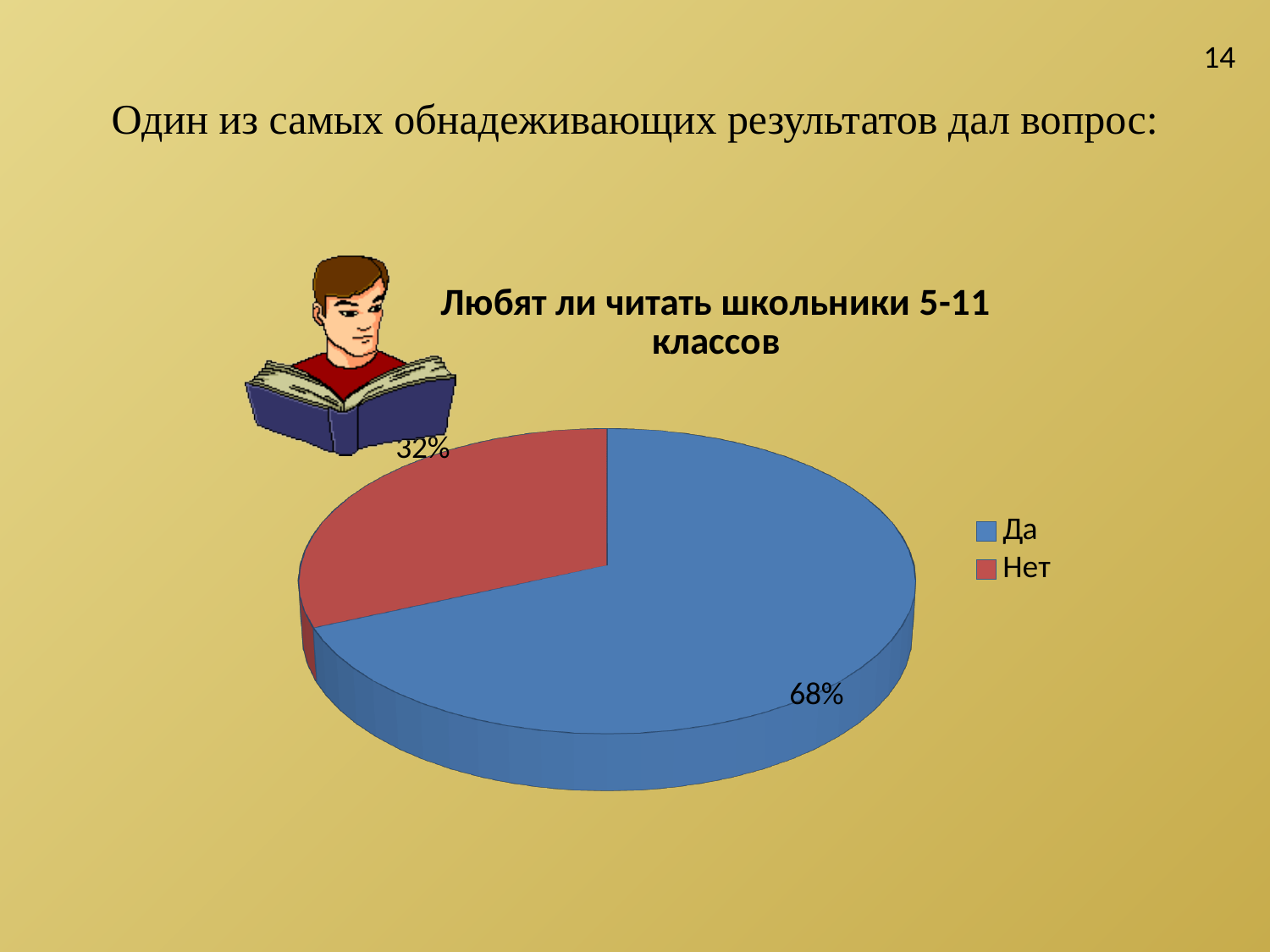
What is the difference in percentage points between the "Да" and "Нет" slices? 36 What is the title of the chart? Любят ли читать школьники 5-11 классов What colour is the "Нет" slice in the pie chart? Red How many slices does the pie chart have? 2 Which category has the smallest share of the pie chart? Нет What percentage of the pie chart corresponds to "Да"? 68% Which slice is larger, "Да" or "Нет"? Да What is the combined share of the "Да" and "Нет" slices? 100% What percentage of the pie chart corresponds to "Нет"? 32% Which category has the largest share of the pie chart? Да How many entries does the legend list? 2 What type of chart is shown on the slide? Pie chart